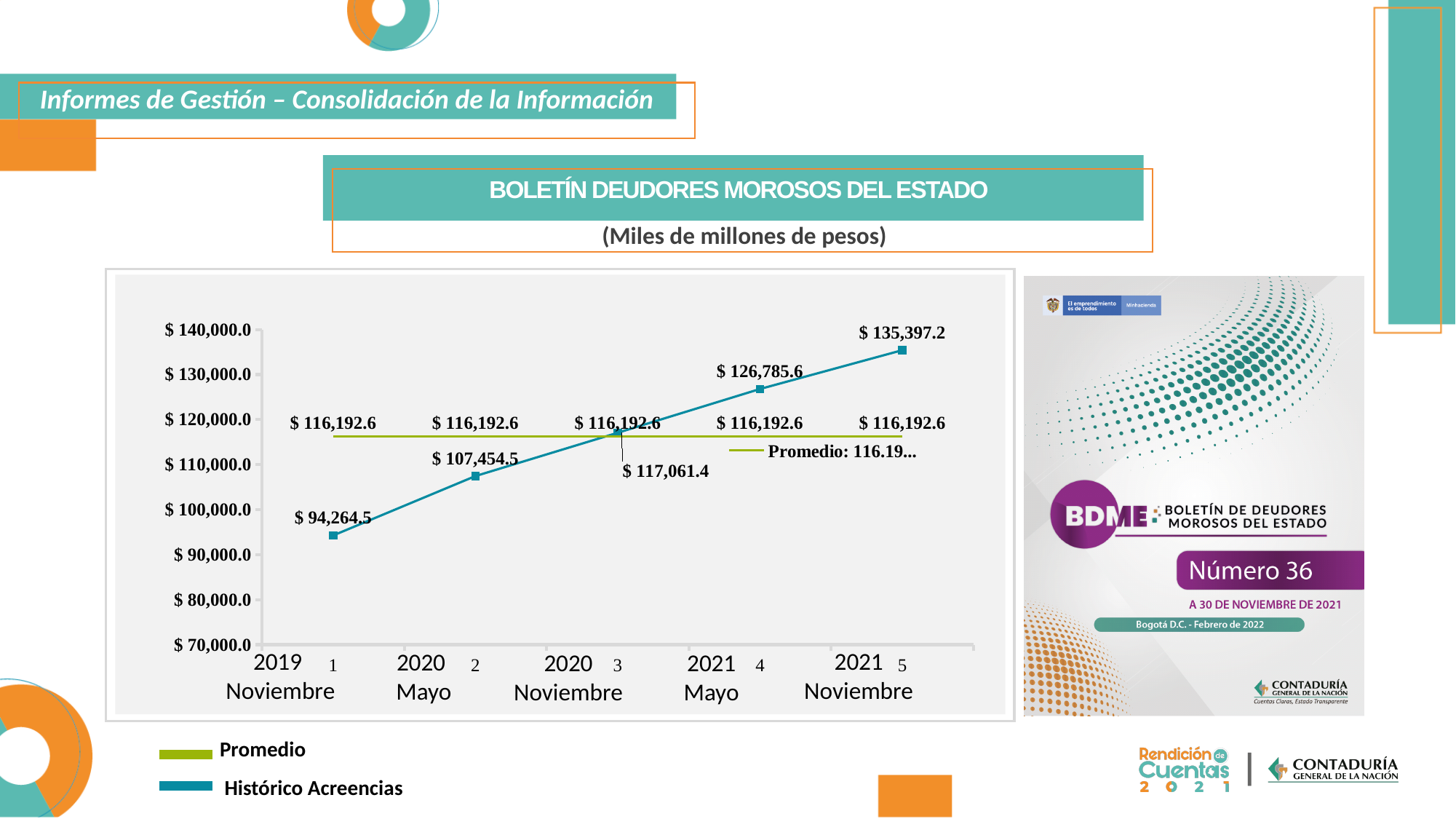
Is the Histórico Acreencias value for 2021 Mayo greater or less than $ 120,000.0? greater What is the difference between the Histórico Acreencias values for 2021 Noviembre and 2019 Noviembre? $ 41,132.7 What is the value of Histórico Acreencias for 2019 Noviembre? $ 94,264.5 Which period has the lowest Histórico Acreencias value? 2019 Noviembre How many series does the legend list? 2 What is the value of Histórico Acreencias for 2021 Noviembre? $ 135,397.2 Which period has the highest Histórico Acreencias value? 2021 Noviembre Does the Histórico Acreencias series rise or fall from 2019 Noviembre to 2021 Noviembre? rise What is the value of the Promedio series shown on the chart? $ 116,192.6 How many periods are plotted on the x axis of the chart? 5 What is the value of Histórico Acreencias for 2020 Mayo? $ 107,454.5 Is the Histórico Acreencias value for 2020 Noviembre larger or smaller than the Promedio value? larger